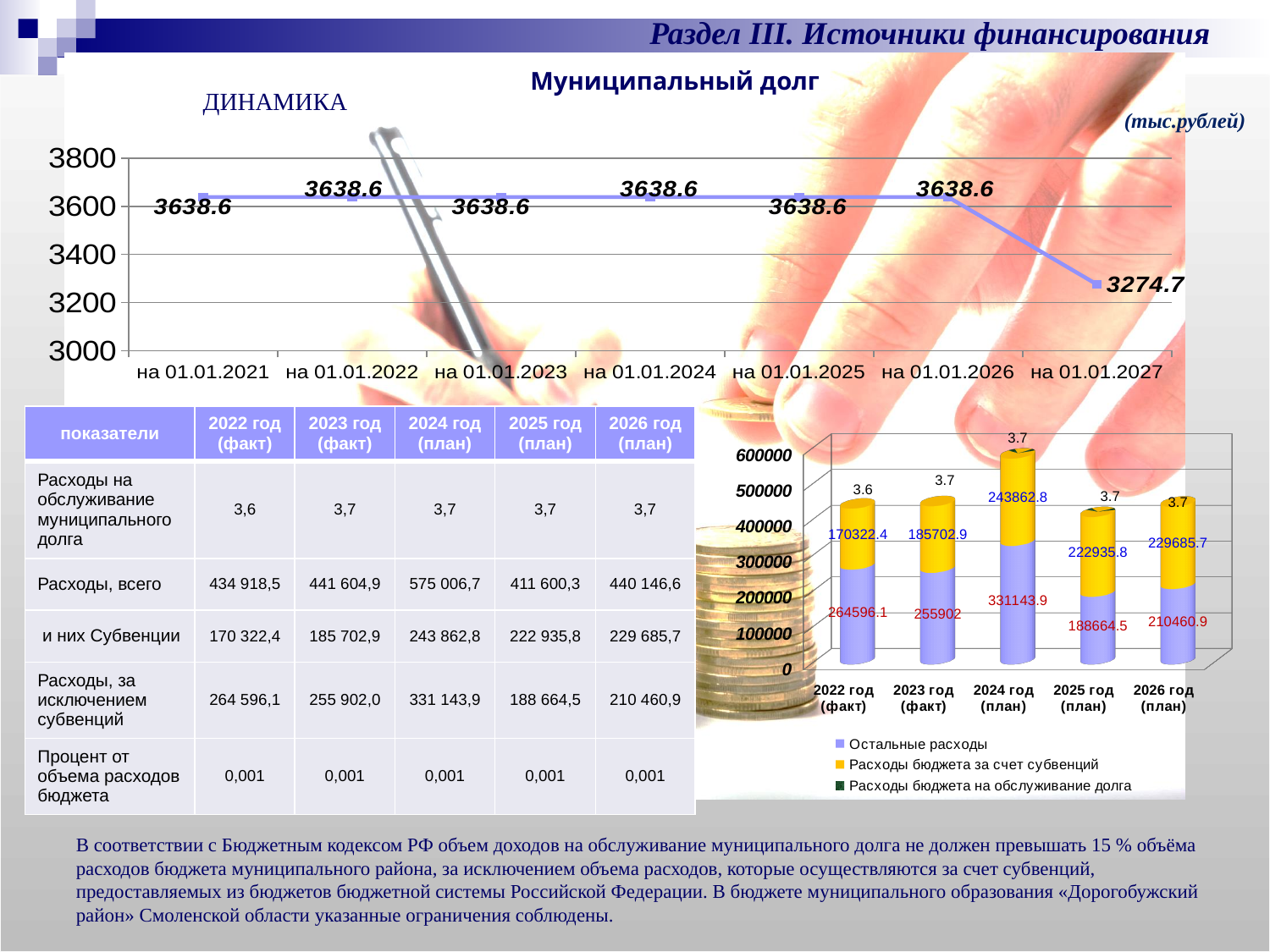
In the stacked bar chart in the bottom right, which category has the highest value for 'Остальные расходы'? 2024 год (план) In the stacked bar chart in the bottom right, how many series does the legend list? 3 What kind of chart is the chart in the bottom right of the slide? stacked bar chart In the line chart 'Муниципальный долг', which date has the lowest value? на 01.01.2027 In the line chart 'Муниципальный долг', how many data points are plotted? 7 In the line chart 'Муниципальный долг', is the value for на 01.01.2027 greater or less than 3400? less In the line chart 'Муниципальный долг', what is the difference between the value for на 01.01.2026 and the value for на 01.01.2027? 363.9 In the line chart 'Муниципальный долг', what is the value for на 01.01.2024? 3638.6 In the stacked bar chart in the bottom right, what is the value of 'Остальные расходы' for 2024 год (план)? 331143.9 In the stacked bar chart in the bottom right, which is larger: 'Расходы бюджета за счет субвенций' for 2022 год (факт) or for 2023 год (факт)? 2023 год (факт) In the stacked bar chart in the bottom right, what is the value of 'Расходы бюджета за счет субвенций' for 2025 год (план)? 222935.8 In the line chart 'Муниципальный долг', what is the value for на 01.01.2027? 3274.7